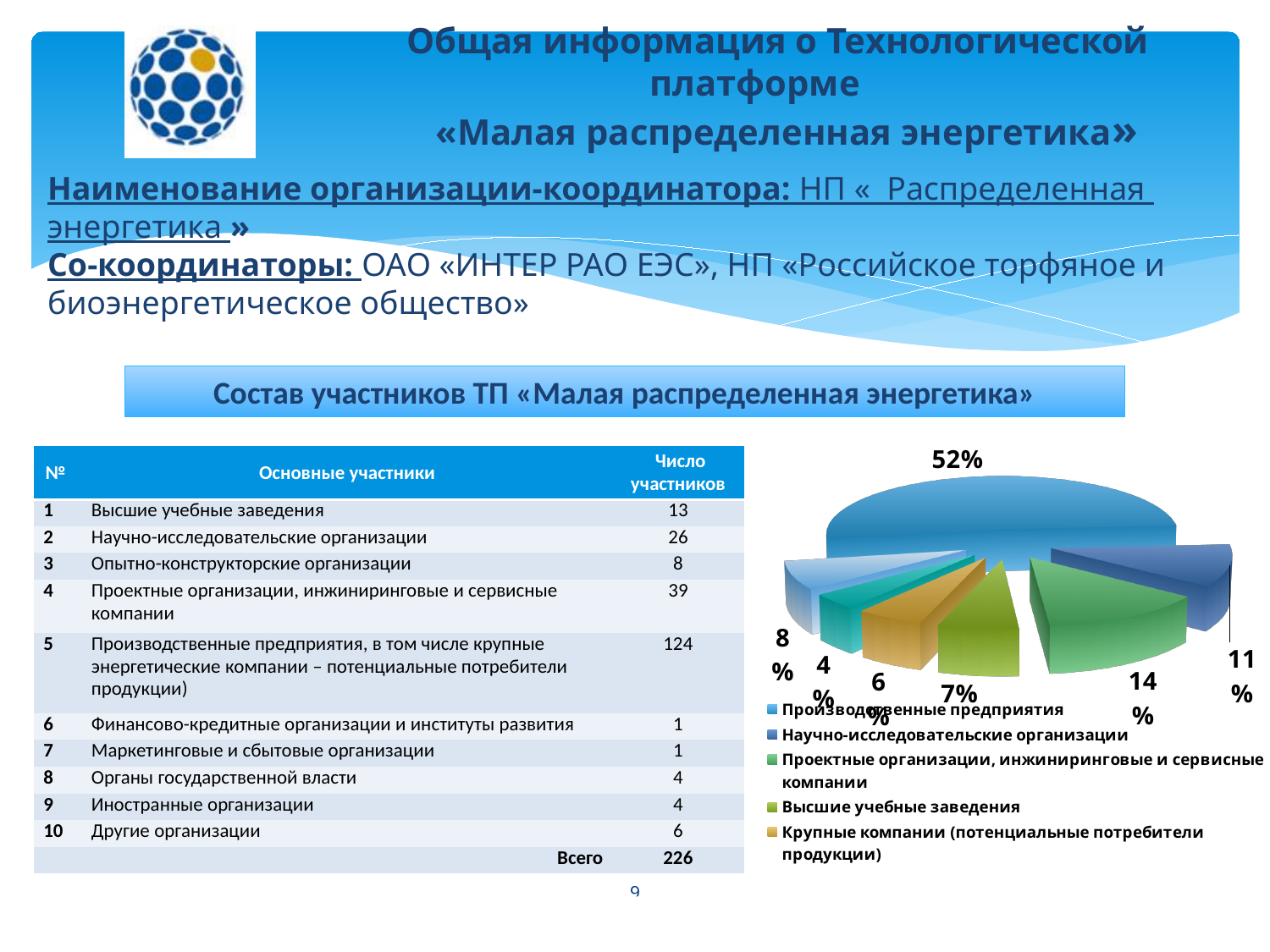
What kind of chart is shown on the right side of the slide? pie chart How many slices are labelled with percentages on the pie chart? 7 How many entries does the pie chart's legend list? 5 Which legend entry corresponds to the largest slice (52%) of the pie chart? Производственные предприятия What is the smallest percentage labelled on the pie chart? 4% Which is larger on the pie chart: the slice labelled 14% or the slice labelled 11%? 14% Which legend entry is listed first in the pie chart's legend? Производственные предприятия What share of the pie chart is labelled for Научно-исследовательские организации (dark blue slice)? 11% What is the difference between the 52% slice and the 14% slice on the pie chart? 38% Which legend entry is listed last in the pie chart's legend? Крупные компании (потенциальные потребители продукции) What share of the pie chart is labelled for Проектные организации, инжиниринговые и сервисные компании (green slice)? 14% What is the largest percentage shown on the pie chart? 52%